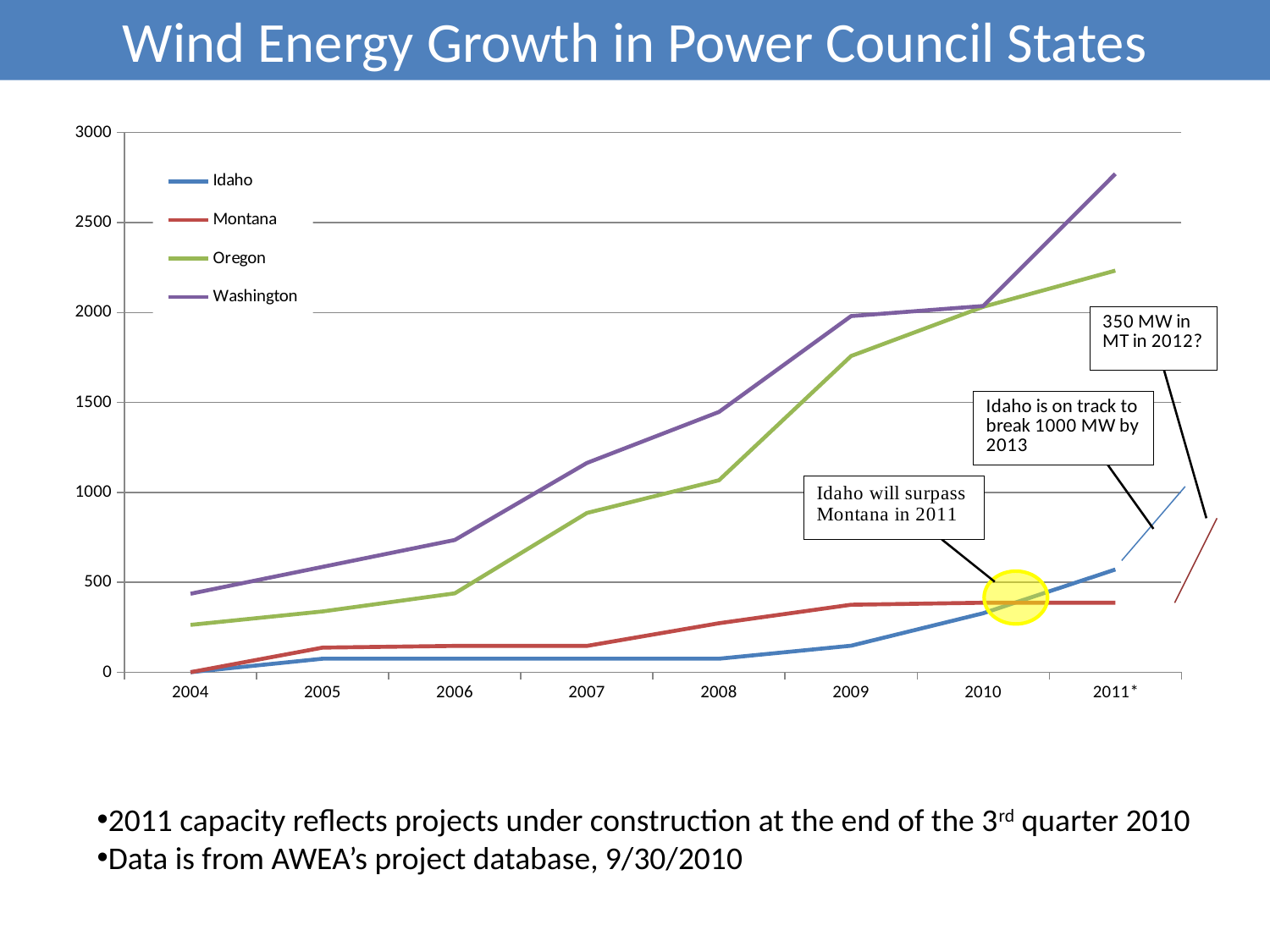
Is the value for Washington in 2011* greater or less than 2500? greater Which state has the lowest value in 2011*? Montana Does the Washington line rise or fall from 2004 to 2011*? rise Is the value for Washington in 2007 greater or less than 1000? greater What kind of chart is shown on the slide? line chart In 2009, which is larger, the value for Washington or the value for Oregon? Washington How many years are shown along the x axis? 8 Which state has the highest value in 2011*? Washington Is the value for Montana in 2011* greater or less than 500? less How many series does the legend list? 4 What is the title of the slide? Wind Energy Growth in Power Council States Which state has the lowest value in 2008? Idaho